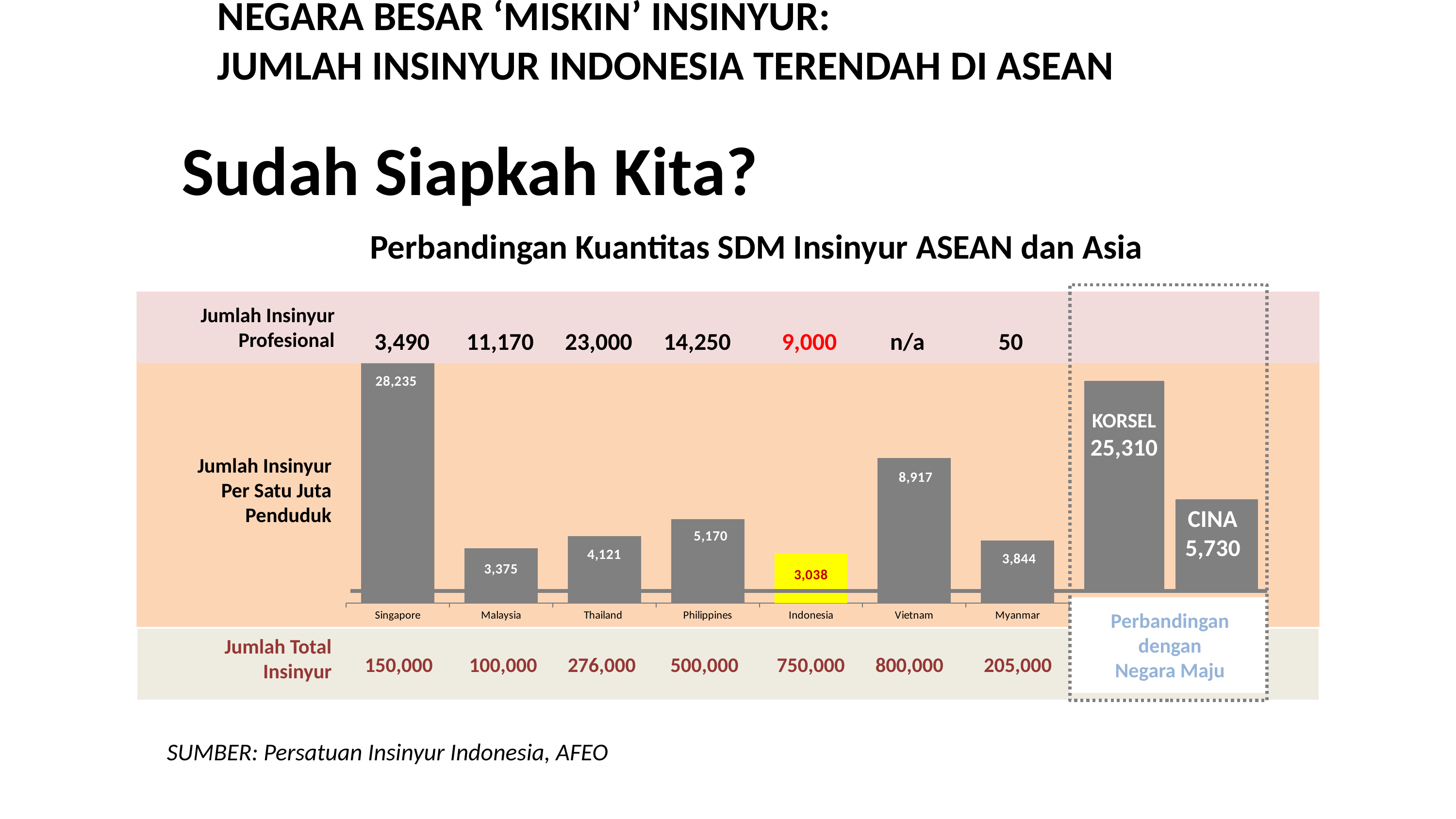
What is the difference in Jumlah Insinyur Per Satu Juta Penduduk between Singapore and Indonesia? 25,197 Which ASEAN country has the lowest Jumlah Insinyur Per Satu Juta Penduduk? Indonesia What is the value of Jumlah Insinyur Per Satu Juta Penduduk for Singapore? 28,235 What is the value of Jumlah Insinyur Per Satu Juta Penduduk for Vietnam? 8,917 What is the title of the chart? Perbandingan Kuantitas SDM Insinyur ASEAN dan Asia What is the value of Jumlah Insinyur Per Satu Juta Penduduk for Indonesia? 3,038 What is the Jumlah Insinyur Per Satu Juta Penduduk shown for CINA? 5,730 Which has a higher Jumlah Insinyur Per Satu Juta Penduduk, Philippines or Thailand? Philippines What is the Jumlah Insinyur Per Satu Juta Penduduk shown for KORSEL? 25,310 How many ASEAN countries are shown as bars in the chart (excluding KORSEL and CINA)? 7 What type of chart is used to show Jumlah Insinyur Per Satu Juta Penduduk? Bar chart Which ASEAN country has the highest Jumlah Insinyur Per Satu Juta Penduduk? Singapore